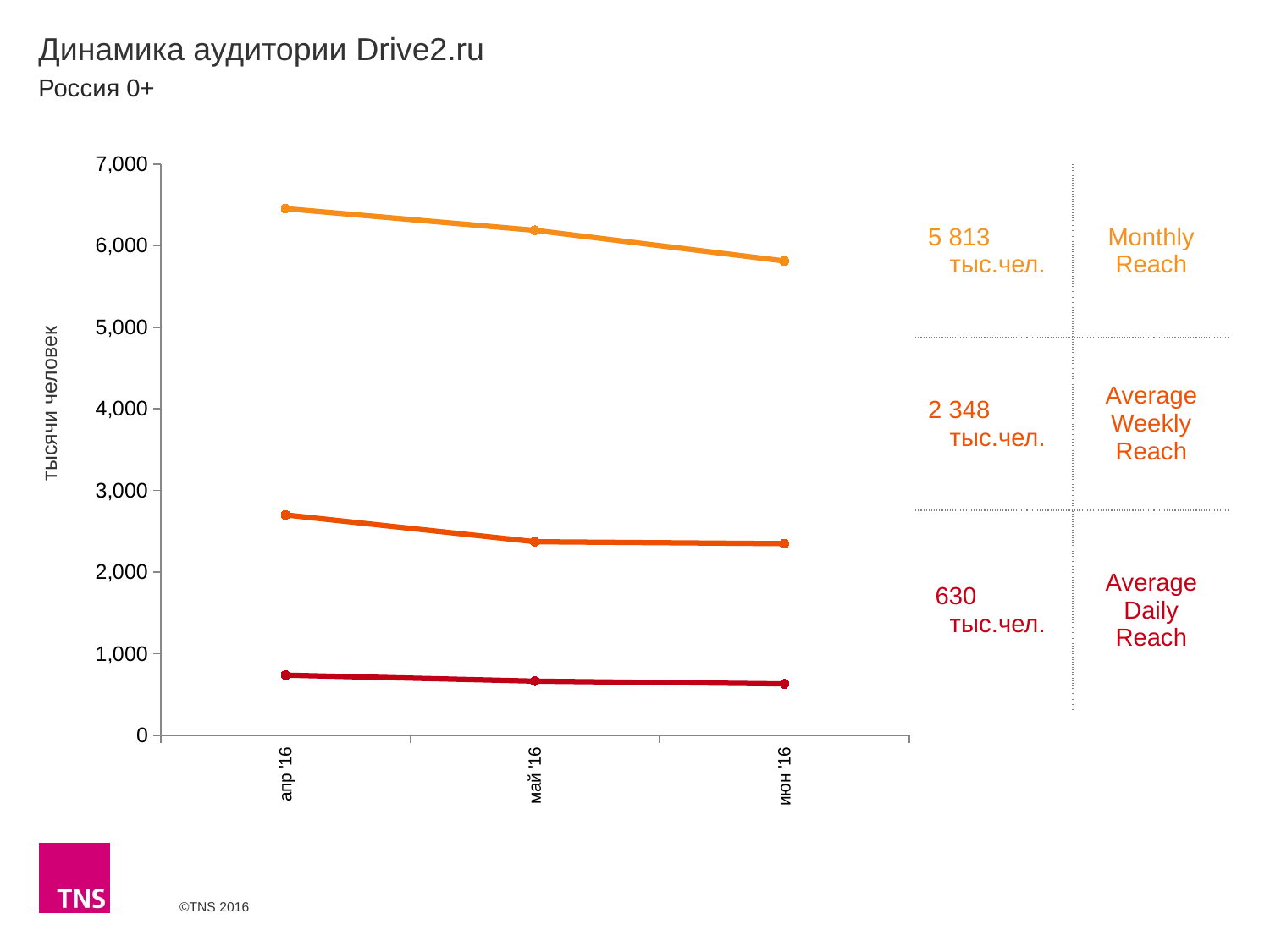
What is the label on the y axis of the chart? тысячи человек What is the Average Weekly Reach value shown for июн '16? 2 348 тыс.чел. Does the Monthly Reach line rise or fall from апр '16 to июн '16? fall What is the Monthly Reach value shown for июн '16? 5 813 тыс.чел. Which series has the lowest values on the chart? Average Daily Reach Is the Average Weekly Reach value for апр '16 greater or less than 2,000? greater What kind of chart is shown on the slide? line chart Which series has the highest values on the chart? Monthly Reach How many series does the chart show? 3 How many time points are plotted along the x axis? 3 Is the Monthly Reach value for апр '16 greater or less than 6,000? greater What is the Average Daily Reach value shown for июн '16? 630 тыс.чел.